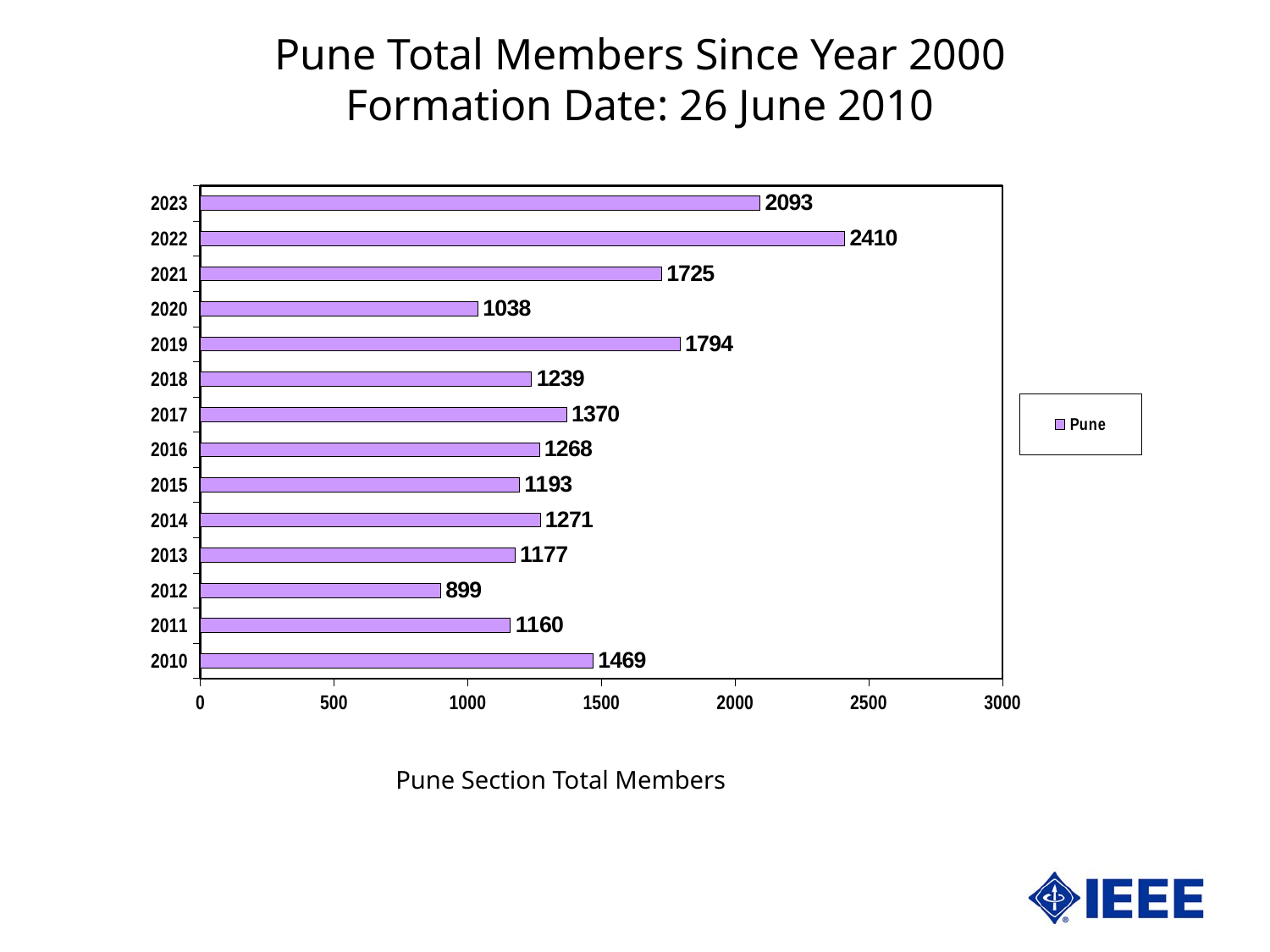
What is the value for 2022? 2410 How many series does the legend list? 1 What is the difference between the values for 2022 and 2023? 317 What series name is shown in the legend? Pune Which year has the highest value? 2022 How many years are shown on the chart? 14 Is the value for 2010 greater or less than 1500? less Which is larger, the value for 2020 or the value for 2021? 2021 What is the value for 2019? 1794 What is the value for 2012? 899 What kind of chart is shown? bar chart Which year has the lowest value? 2012